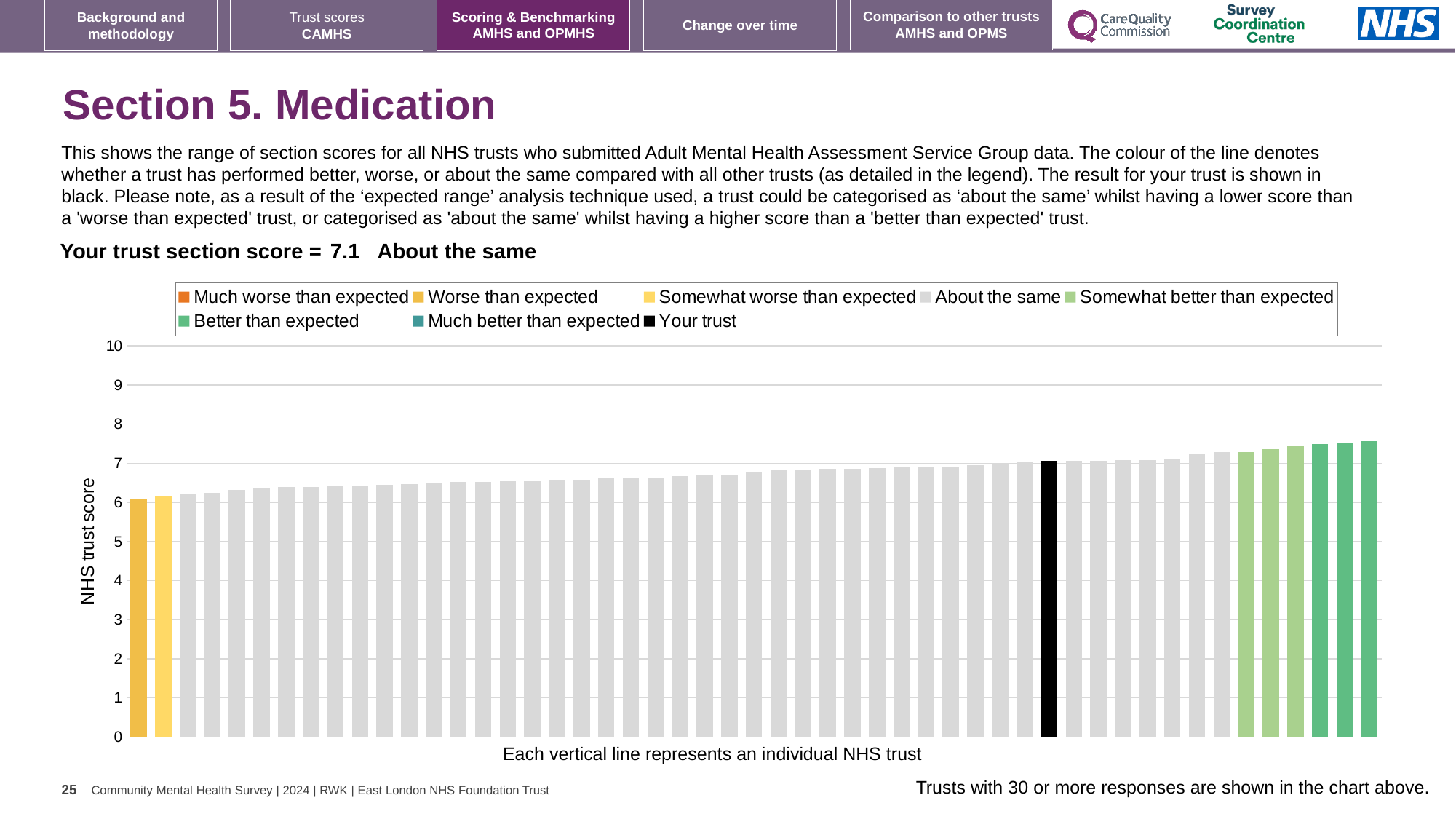
Is the value of the rightmost bar greater or less than 7? greater Is the rightmost bar taller or shorter than the leftmost bar? Taller Is the value of the lowest bar greater or less than 5? greater What colour does the legend use for 'Your trust'? Black Which category is your trust placed in for this section? About the same Is the value of the leftmost bar greater or less than 7? less What kind of chart is shown on the slide? Bar chart What is the label on the vertical axis of the chart? NHS trust score What is the section score for your trust shown on the slide? 7.1 Do the bar values rise or fall from left to right along the x axis? Rise How many entries does the chart legend list? 8